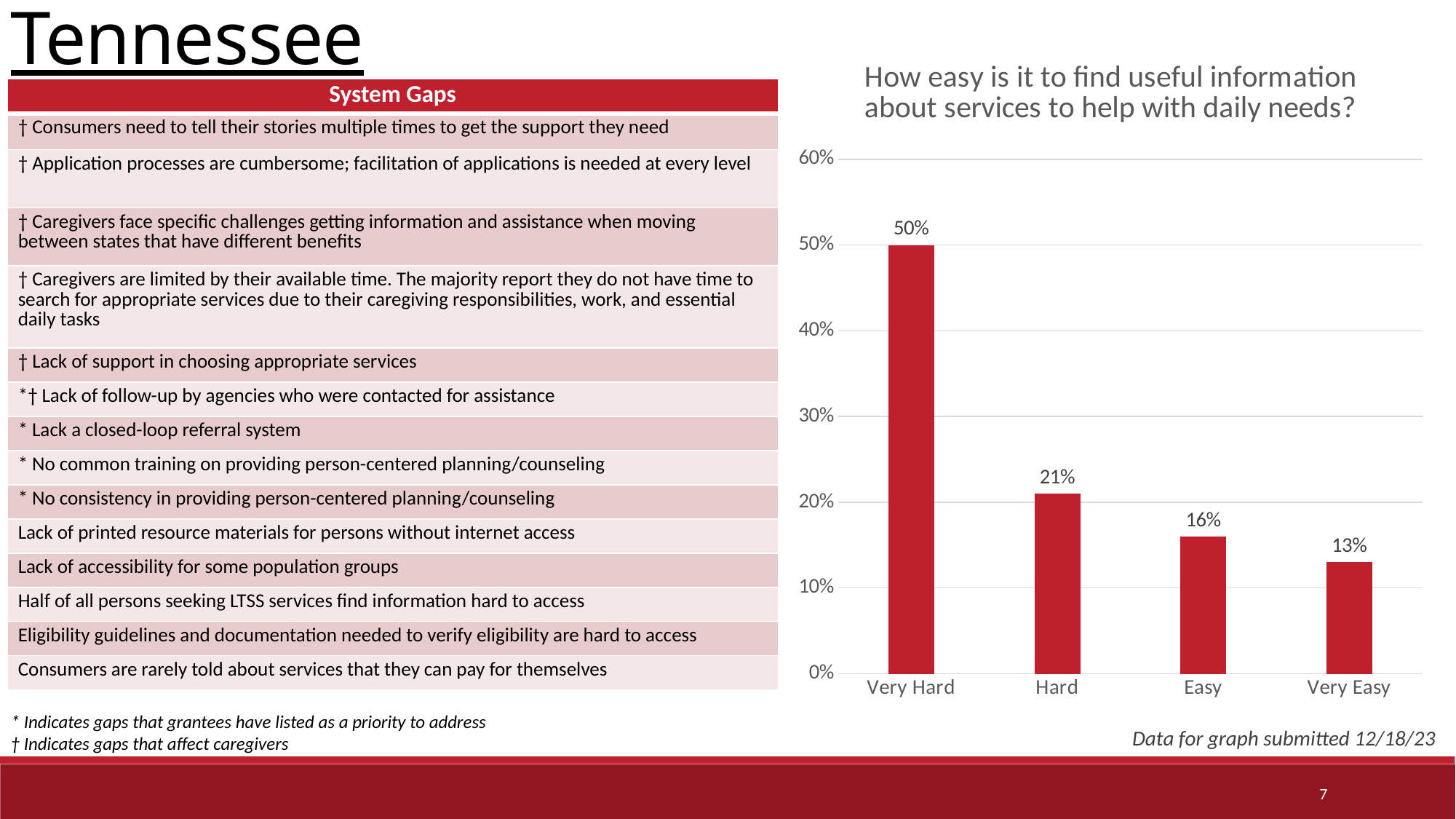
What is the difference between the Very Hard and Hard values? 29% What kind of chart is shown on the slide? Bar chart Which is larger, the value for Hard or the value for Easy? Hard What is the value for the Hard category? 21% How many categories are shown on the x axis of the chart? 4 Which category has the highest value? Very Hard Which category has the lowest value? Very Easy What is the difference between the Easy and Very Easy values? 3% What is the value for the Easy category? 16% What percentage of respondents said it is Very Hard to find useful information about services? 50% Do the values rise or fall moving from Very Hard to Very Easy along the x axis? Fall What is the value for the Very Easy category? 13%